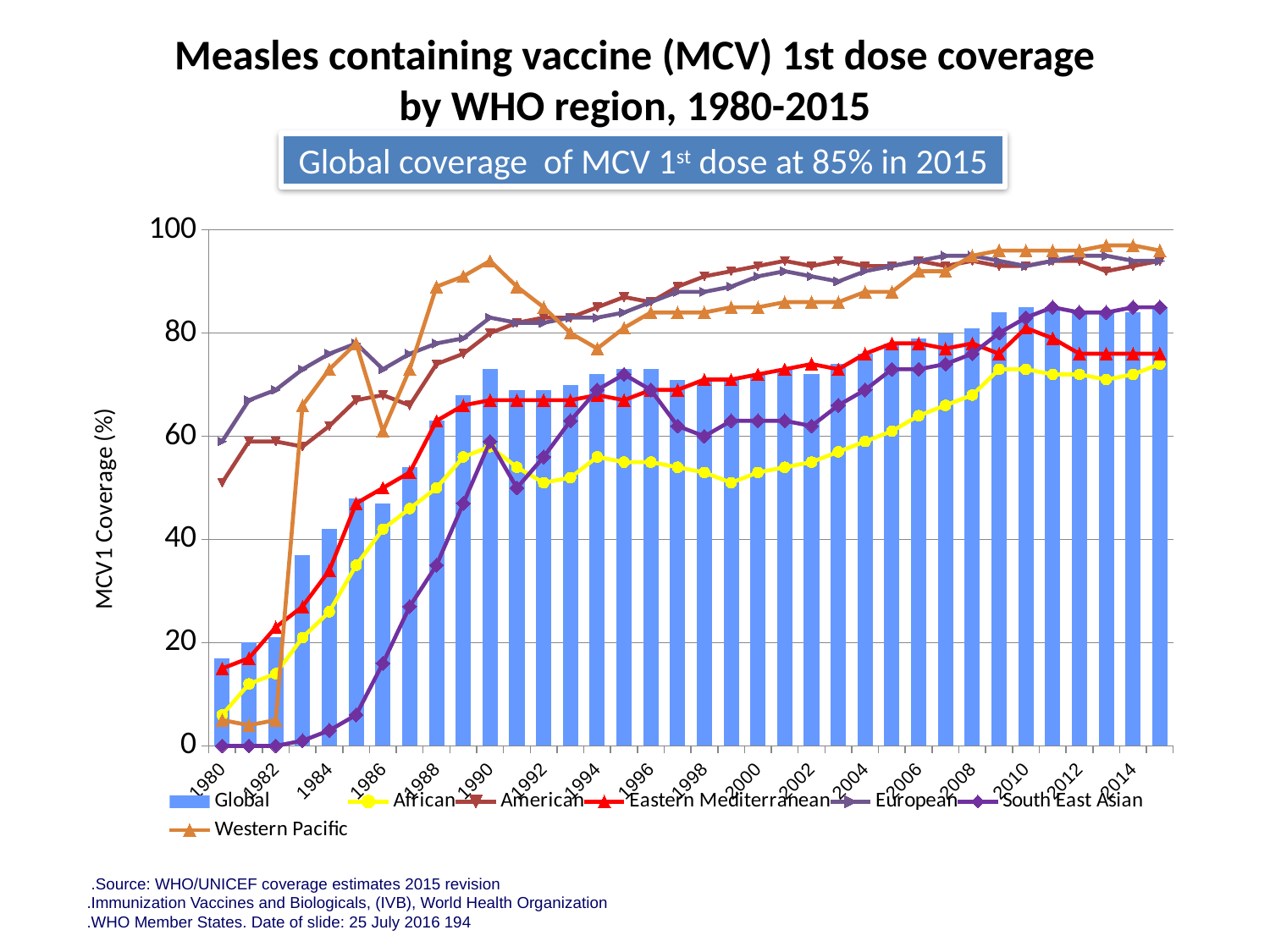
How many years are plotted on the x axis of the chart? 36 What kind of chart is shown on the slide? A combined bar and line chart Which region has the lowest coverage in 2015? African Is the American value for 1980 greater or less than 40? greater What was the global coverage of MCV 1st dose in 2015, as stated on the slide? 85% Which region has the lowest coverage in 1980? South East Asian Is the Global value for 1980 greater or less than 20? less In 2000, which is larger: the American value or the African value? American Is the Western Pacific value for 1990 greater or less than 80? greater Do the Global bars generally rise or fall from 1980 to 2015? rise Which region has the highest coverage in 1980? European How many series does the chart legend list? 7